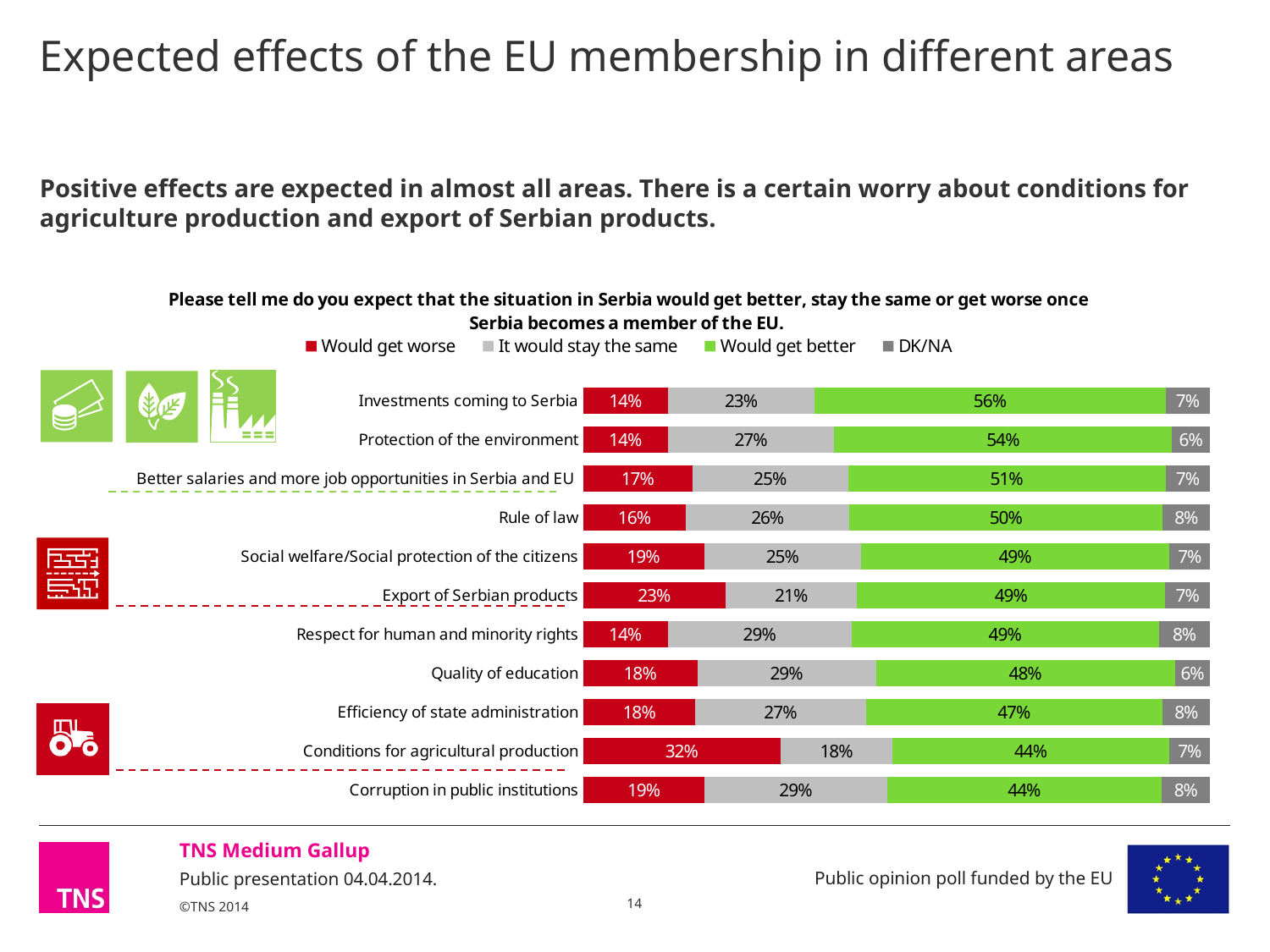
How many series does the legend list? 4 What is the difference between the 'Would get better' values for Investments coming to Serbia and Corruption in public institutions? 12 percentage points What type of chart is shown on the slide? Stacked bar chart Which has a larger 'Would get worse' value: Export of Serbian products or Rule of law? Export of Serbian products What is the DK/NA value for Quality of education? 6% Which area has the highest 'Would get worse' value? Conditions for agricultural production How many areas (categories) are shown in the chart? 11 What is the 'It would stay the same' value for Respect for human and minority rights? 29% Which area has the highest 'Would get better' value? Investments coming to Serbia What is the total of the stacked bar for Rule of law? 100% What percentage of respondents expect that investments coming to Serbia would get better? 56% What is the 'Would get worse' value for Conditions for agricultural production? 32%